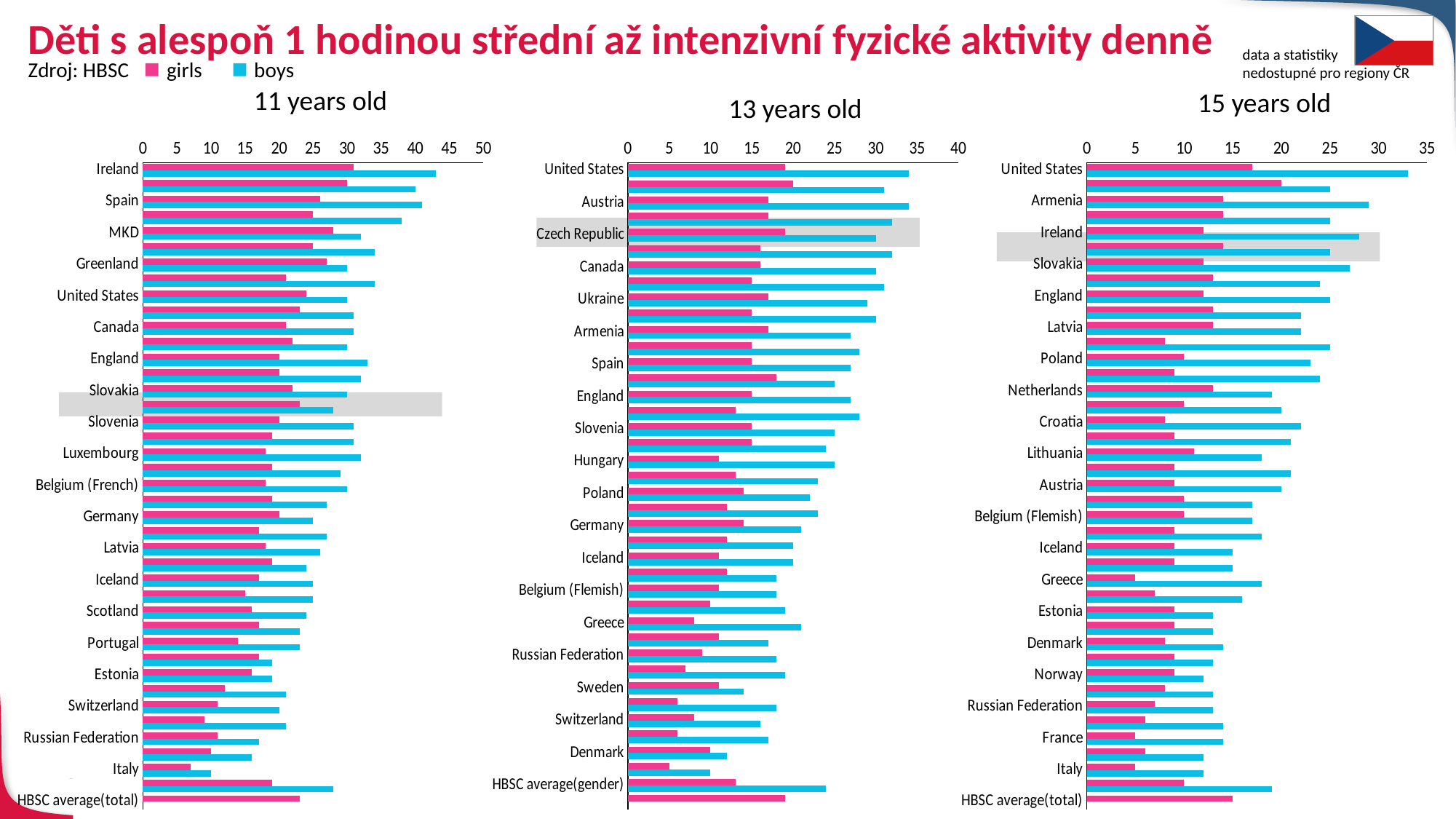
In the '13 years old' chart, is the girls value for Denmark greater or less than 15? less Which colour represents girls in the legend? pink In the '11 years old' chart, is the boys value for Italy greater or less than 15? less In the '13 years old' chart, which is larger for Hungary, the girls value or the boys value? boys In the '15 years old' chart, which is larger for Greece, the girls value or the boys value? boys In the '11 years old' chart, is the boys value for Ireland greater or less than 40? greater How many series does the legend list? 2 What is the title of the middle chart? 13 years old In the '11 years old' chart, which is larger for Ireland, the girls value or the boys value? boys What kind of chart is the '11 years old' chart? bar chart